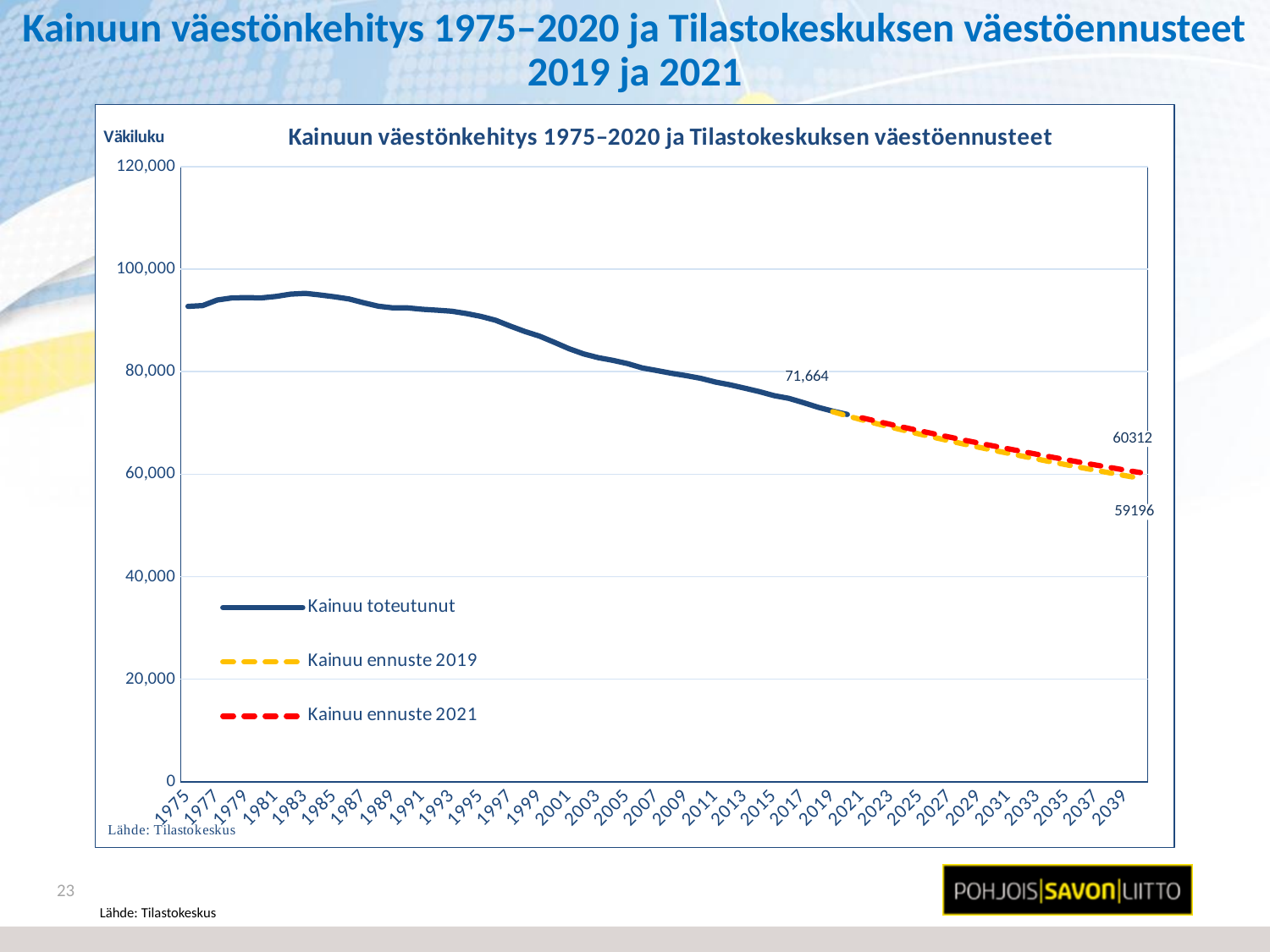
What is the difference between the labelled value 71,664 and the Kainuu ennuste 2021 end value 60312? 11352 What is the difference between the labelled end values of Kainuu ennuste 2021 (60312) and Kainuu ennuste 2019 (59196)? 1116 Is the value for Kainuu toteutunut in 1975 greater or less than 80,000? greater What label is shown on the vertical axis of the chart? Väkiluku How many series does the chart legend list? 3 What is the labelled end value of the Kainuu ennuste 2021 series? 60312 What is the labelled value at the end of the Kainuu toteutunut series? 71,664 Which forecast series ends at a higher value, Kainuu ennuste 2019 or Kainuu ennuste 2021? Kainuu ennuste 2021 What kind of chart is shown on the slide? line chart Does the Kainuu toteutunut series rise or fall between 1985 and 2020? fall Is the value for Kainuu toteutunut in 2015 greater or less than 80,000? less What is the labelled end value of the Kainuu ennuste 2019 series? 59196